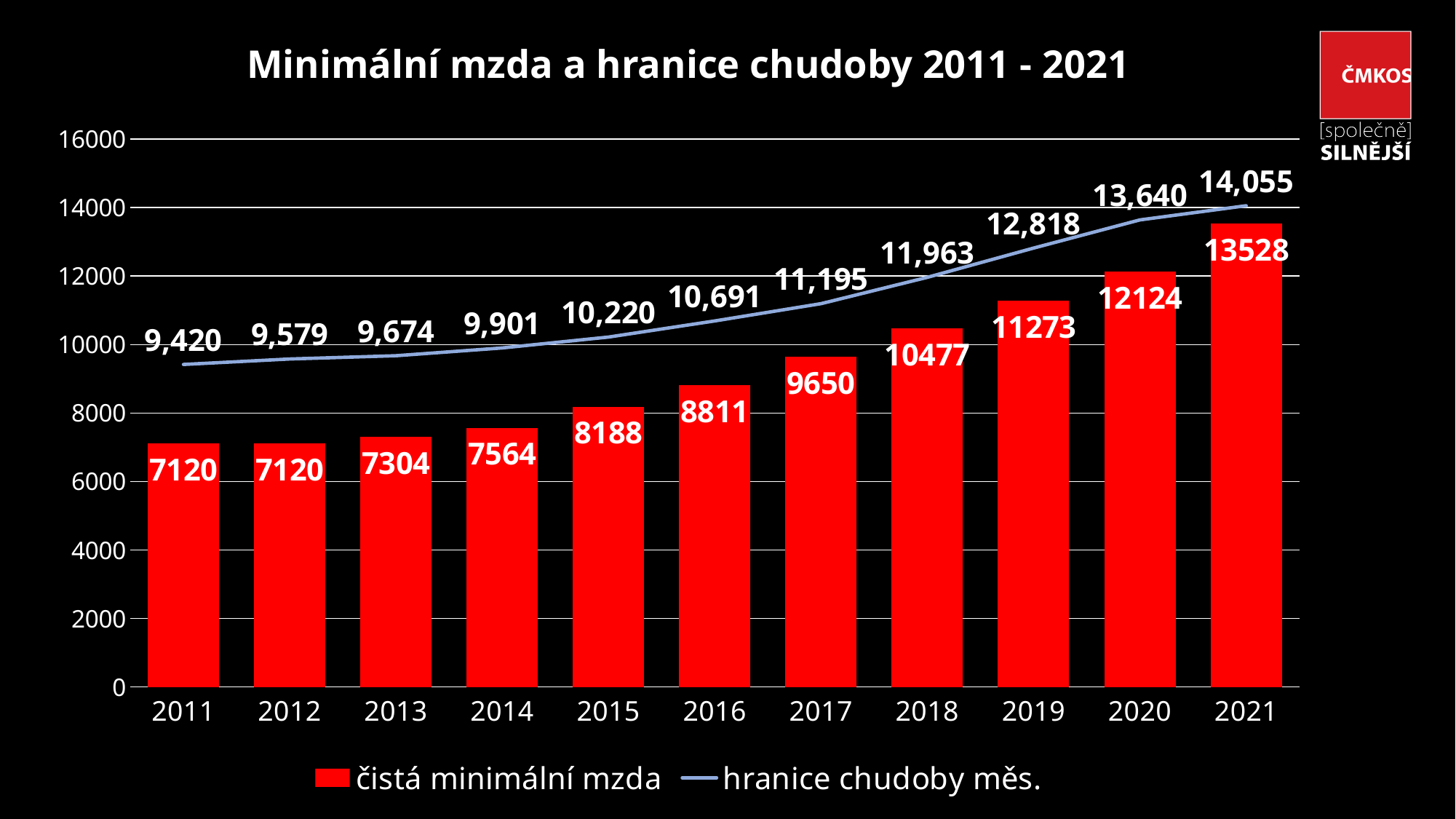
What is the overall trend of čistá minimální mzda from 2011 to 2021? rising Which year has the lowest value of čistá minimální mzda? 2011 and 2012 Which is larger in 2019, čistá minimální mzda or hranice chudoby měs.? hranice chudoby měs. What is the value of čistá minimální mzda for 2021? 13528 What is the value of čistá minimální mzda for 2017? 9650 How many series does the legend list? 2 How many years are shown on the x axis? 11 What is the difference between hranice chudoby měs. and čistá minimální mzda in 2021? 527 Which year has the highest value of hranice chudoby měs.? 2021 By how much did čistá minimální mzda increase from 2011 to 2021? 6408 What is the value of hranice chudoby měs. for 2015? 10,220 Is the value of čistá minimální mzda for 2018 greater or less than 10000? greater